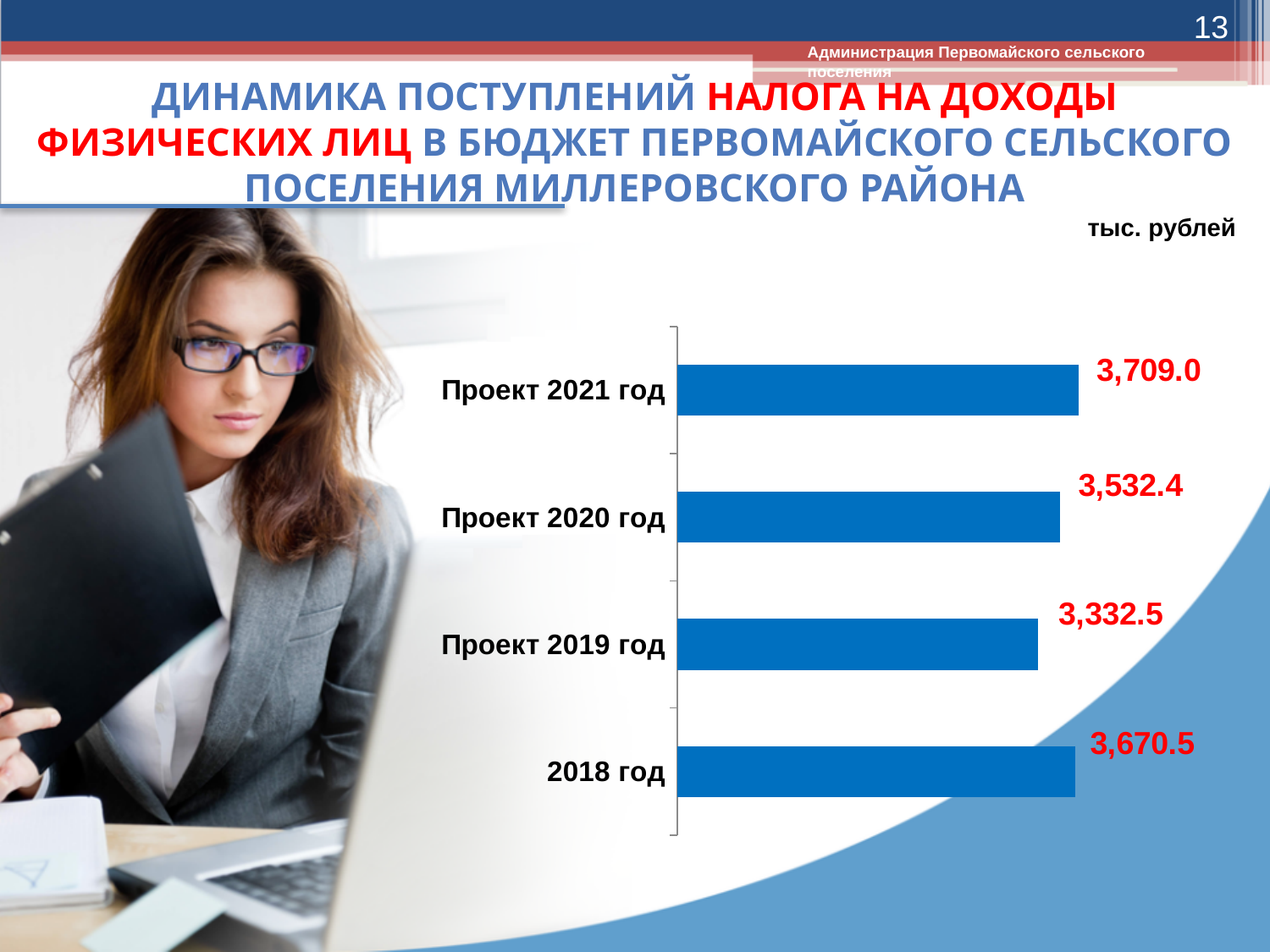
What is the value for Проект 2021 год? 3,709.0 In what units are the values on the chart expressed? тыс. рублей How many categories are shown in the chart? 4 What is the value for Проект 2019 год? 3,332.5 What is the difference between the values for Проект 2021 год and Проект 2020 год? 176.6 What is the difference between the values for 2018 год and Проект 2019 год? 338.0 What is the value for 2018 год? 3,670.5 Which is larger, the value for 2018 год or the value for Проект 2020 год? 2018 год Which category has the lowest value? Проект 2019 год What kind of chart is shown on the slide? Bar chart What is the value for Проект 2020 год? 3,532.4 Which category has the highest value? Проект 2021 год